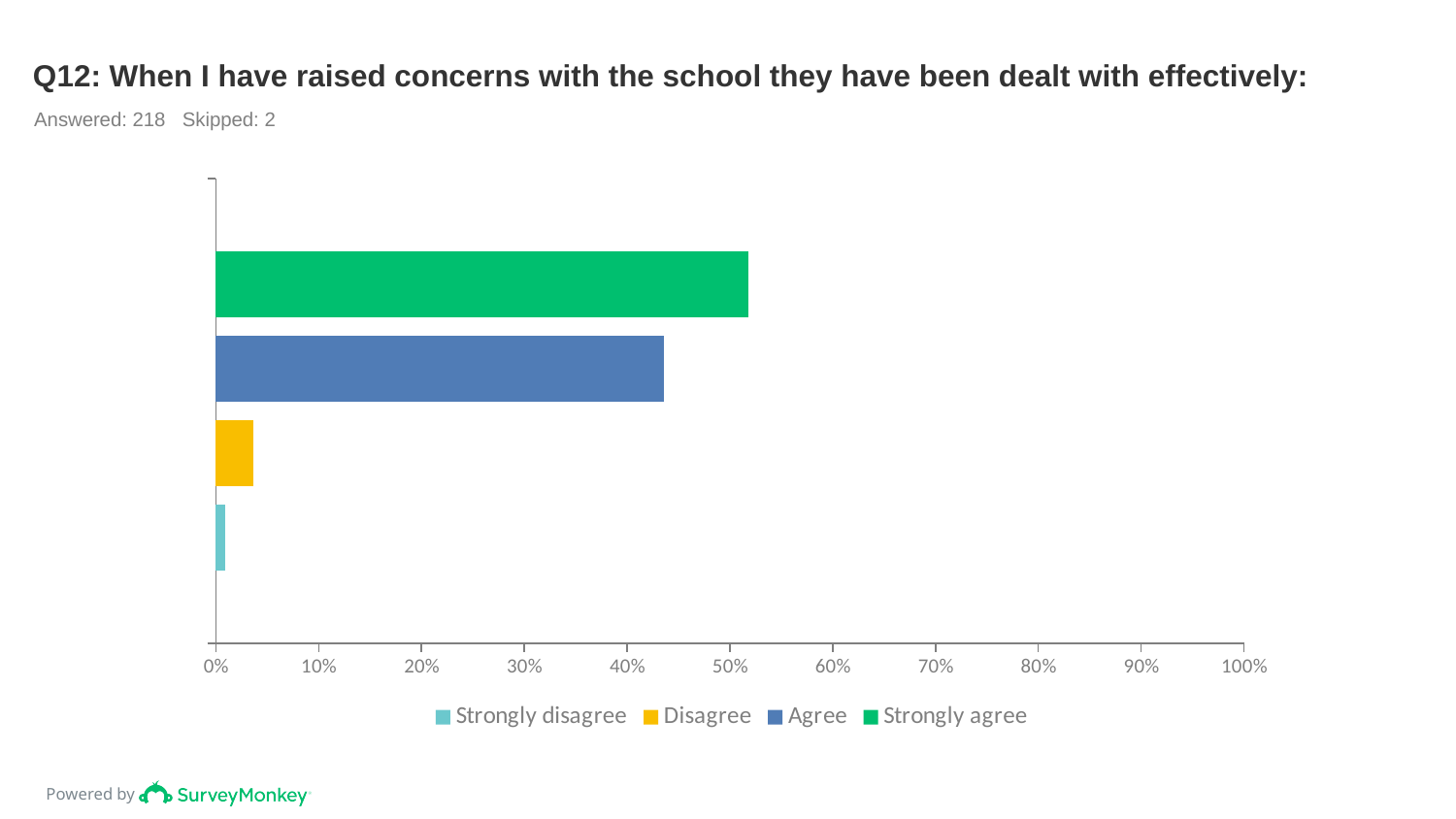
Is the value for Disagree greater or less than 10%? less Which response category has the lowest value? Strongly disagree How many response categories does the legend list? 4 Which is larger, the value for Agree or the value for Strongly agree? Strongly agree Which response category has the highest value? Strongly agree Is the value for Strongly agree greater or less than 50%? greater Is the value for Agree greater or less than 50%? less What colour is the bar for Strongly agree? Green Which is larger, the value for Disagree or the value for Strongly disagree? Disagree How many bars are plotted on the chart? 4 What kind of chart is shown on the slide? Bar chart